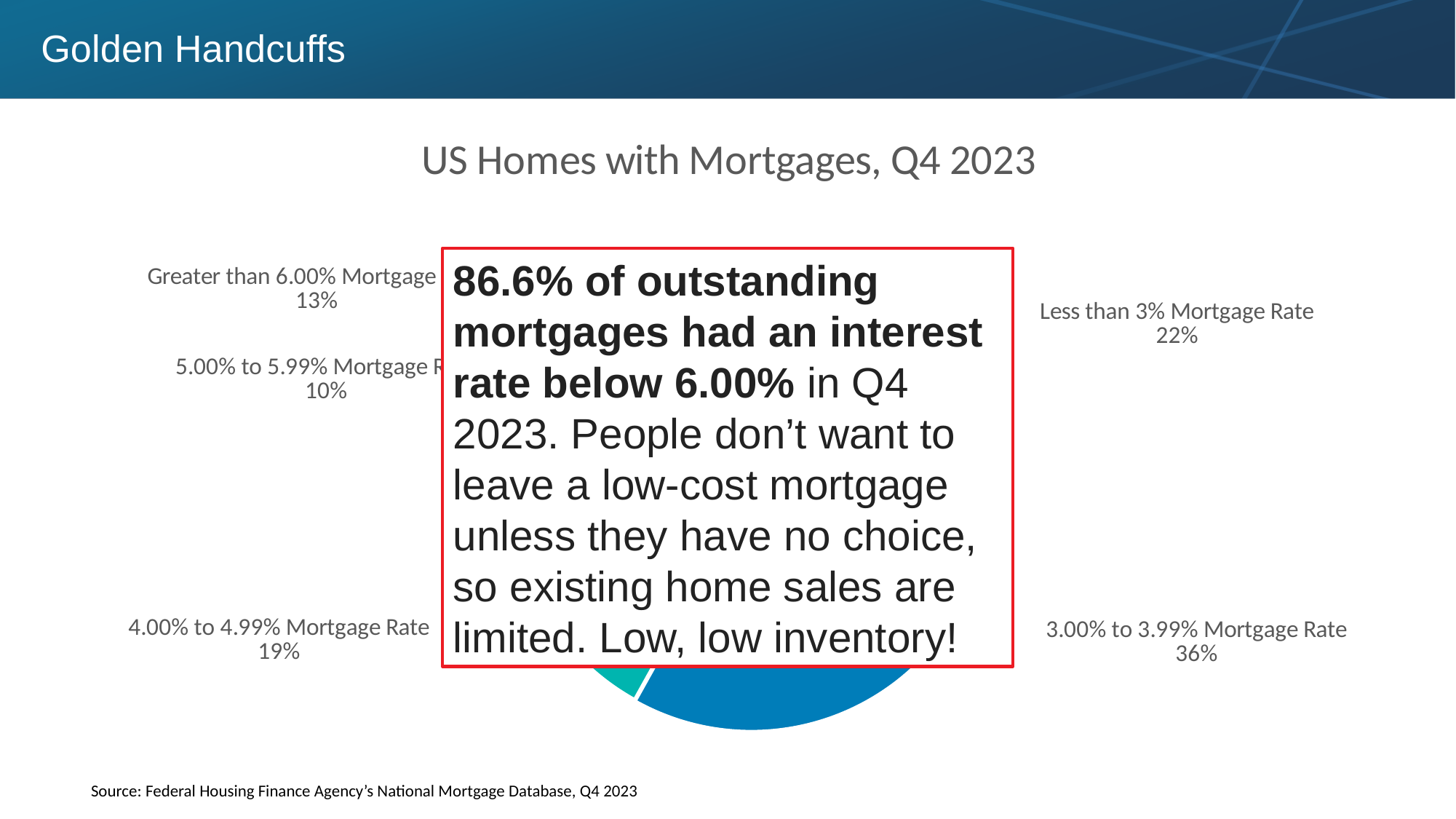
What share of US homes with mortgages had a mortgage rate greater than 6.00%? 13% Which mortgage rate category has the largest share of the pie? 3.00% to 3.99% Mortgage Rate What share of US homes with mortgages had a 5.00% to 5.99% mortgage rate? 10% What share of US homes with mortgages had a mortgage rate less than 3%? 22% What is the title of the chart? US Homes with Mortgages, Q4 2023 How many percentage points larger is the 3.00% to 3.99% Mortgage Rate share than the Less than 3% Mortgage Rate share? 14 percentage points What share of US homes with mortgages had a 4.00% to 4.99% mortgage rate? 19% What kind of chart is shown on the slide? pie chart What share of US homes with mortgages had a 3.00% to 3.99% mortgage rate? 36% How many mortgage rate categories are labelled on the pie chart? 5 Which is larger: the share for 4.00% to 4.99% Mortgage Rate or the share for Greater than 6.00% Mortgage Rate? 4.00% to 4.99% Mortgage Rate Which mortgage rate category has the smallest share of the pie? 5.00% to 5.99% Mortgage Rate